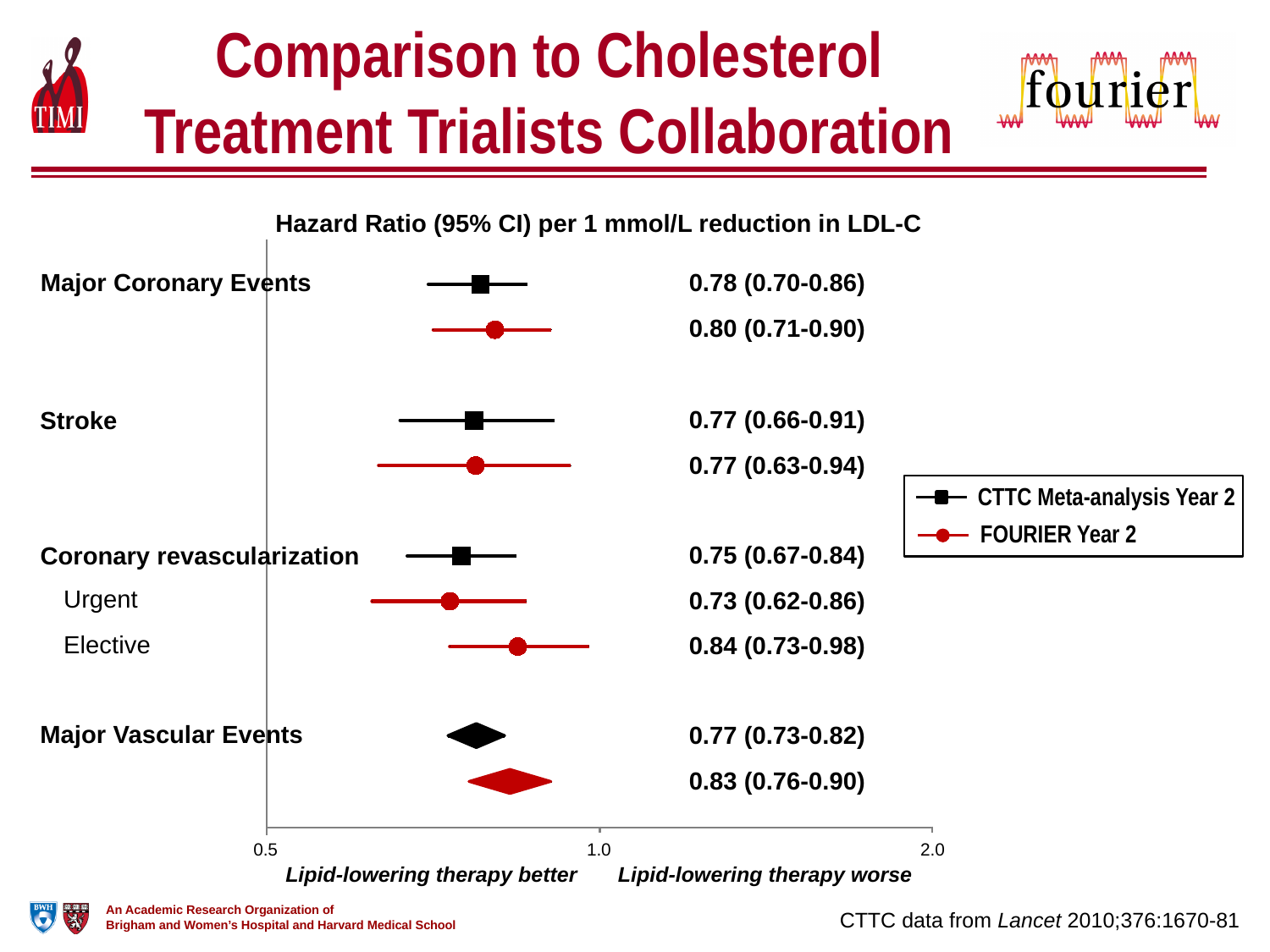
What is the hazard ratio (95% CI) for Major Coronary Events in the FOURIER Year 2 series? 0.80 (0.71-0.90) What is the hazard ratio (95% CI) for Major Vascular Events in the CTTC Meta-analysis Year 2 series? 0.77 (0.73-0.82) What is the hazard ratio (95% CI) for Major Coronary Events in the CTTC Meta-analysis Year 2 series? 0.78 (0.70-0.86) For Major Vascular Events, which series has the larger hazard ratio point estimate, CTTC Meta-analysis Year 2 or FOURIER Year 2? FOURIER Year 2 What kind of chart is shown on the slide? Forest plot What is the hazard ratio (95% CI) for Stroke in the FOURIER Year 2 series? 0.77 (0.63-0.94) Which FOURIER Year 2 outcome has the highest hazard ratio point estimate? Elective coronary revascularization What is the difference between the FOURIER Year 2 and CTTC Meta-analysis Year 2 hazard ratio point estimates for Major Vascular Events? 0.06 How many series does the legend list? 2 What is the hazard ratio (95% CI) for Elective coronary revascularization in the FOURIER Year 2 series? 0.84 (0.73-0.98) Which FOURIER Year 2 outcome has the lowest hazard ratio point estimate? Urgent coronary revascularization Is the hazard ratio for Urgent coronary revascularization in FOURIER Year 2 greater or less than 1.0? less